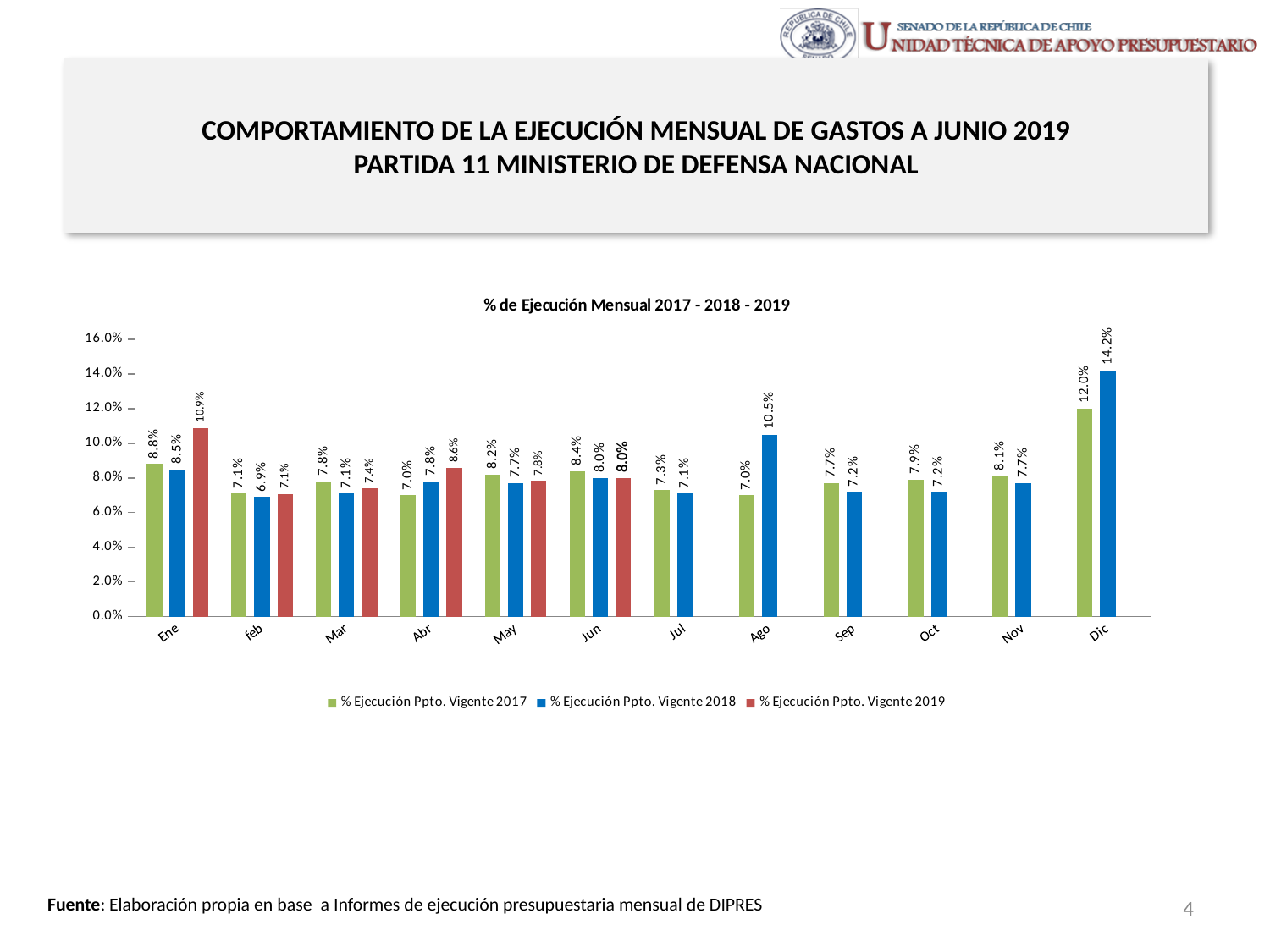
What is the value of % Ejecución Ppto. Vigente 2018 for Dic? 14.2% Which month has the lowest value for % Ejecución Ppto. Vigente 2018? feb What kind of chart is shown on the slide? Bar chart Which is larger for Mar: the 2017 value or the 2019 value? 2017 value How many series does the legend list? 3 Is the value of % Ejecución Ppto. Vigente 2018 for Ago greater or less than 10.0%? greater Which month has the highest value for % Ejecución Ppto. Vigente 2017? Dic What is the value of % Ejecución Ppto. Vigente 2019 for Ene? 10.9% What is the title of the chart? % de Ejecución Mensual 2017 - 2018 - 2019 How many months are shown on the x axis? 12 What is the value of % Ejecución Ppto. Vigente 2017 for Abr? 7.0% What is the difference between the 2018 and 2017 values for Ago? 3.5%